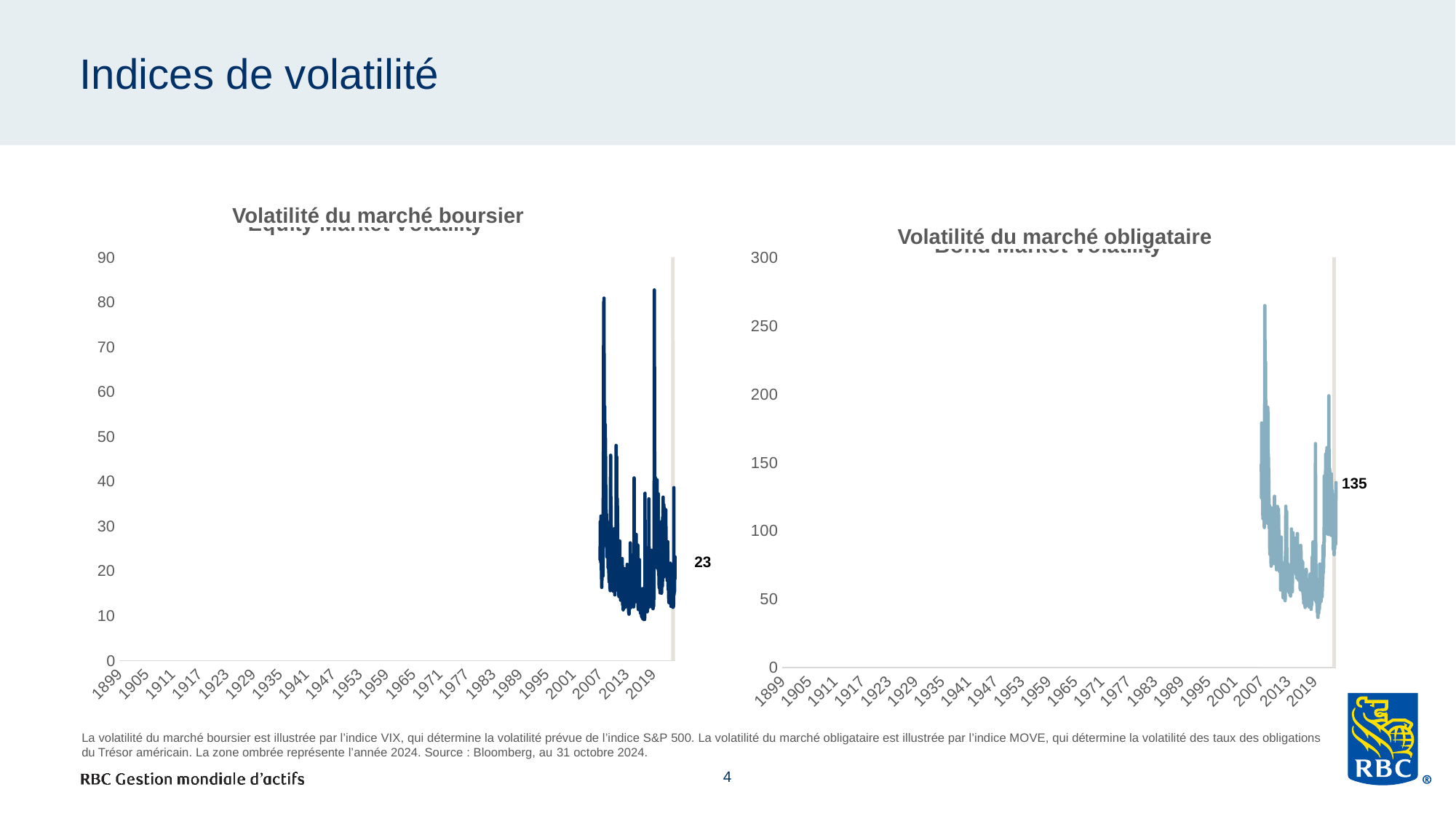
On the 'Volatilité du marché boursier' chart, is the latest value greater or less than 30? less On the 'Volatilité du marché boursier' chart, is the highest peak of the line greater or less than 70? greater What is the highest value shown on the vertical axis of the 'Volatilité du marché obligataire' chart? 300 Which chart shows a higher latest labelled value, 'Volatilité du marché boursier' or 'Volatilité du marché obligataire'? Volatilité du marché obligataire What is the difference between the latest labelled value on the 'Volatilité du marché obligataire' chart and the latest labelled value on the 'Volatilité du marché boursier' chart? 112 What kind of chart is the 'Volatilité du marché obligataire' chart? Line chart What is the title of the left chart on the slide? Volatilité du marché boursier On the 'Volatilité du marché boursier' chart, what is the latest value shown by the data label at the end of the line? 23 On the 'Volatilité du marché obligataire' chart, is the highest peak of the line greater or less than 250? greater On the 'Volatilité du marché obligataire' chart, what is the latest value shown by the data label at the end of the line? 135 What kind of chart is the 'Volatilité du marché boursier' chart? Line chart